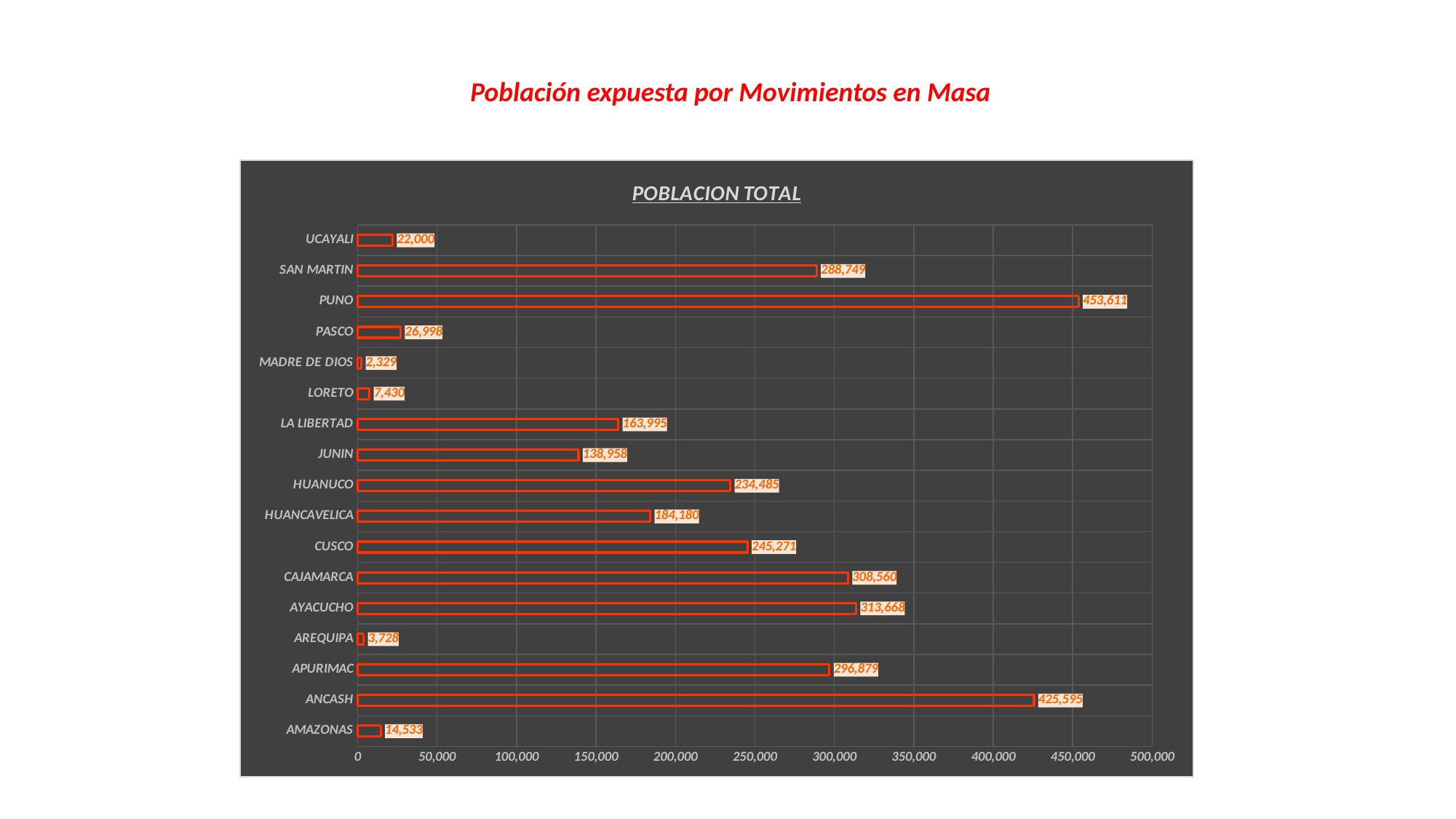
What is the value for PUNO? 453,611 What is the difference between the values for CUSCO and HUANUCO? 10,786 Which category has the lowest value? MADRE DE DIOS Is the value for LA LIBERTAD greater or less than 150,000? greater What is the title of the chart? POBLACION TOTAL What is the difference between the values for PUNO and ANCASH? 28,016 What is the value for AMAZONAS? 14,533 Which is larger, the value for SAN MARTIN or the value for APURIMAC? APURIMAC Which category has the highest value? PUNO What kind of chart is shown? bar chart How many categories are shown in the chart? 17 What is the value for HUANCAVELICA? 184,180